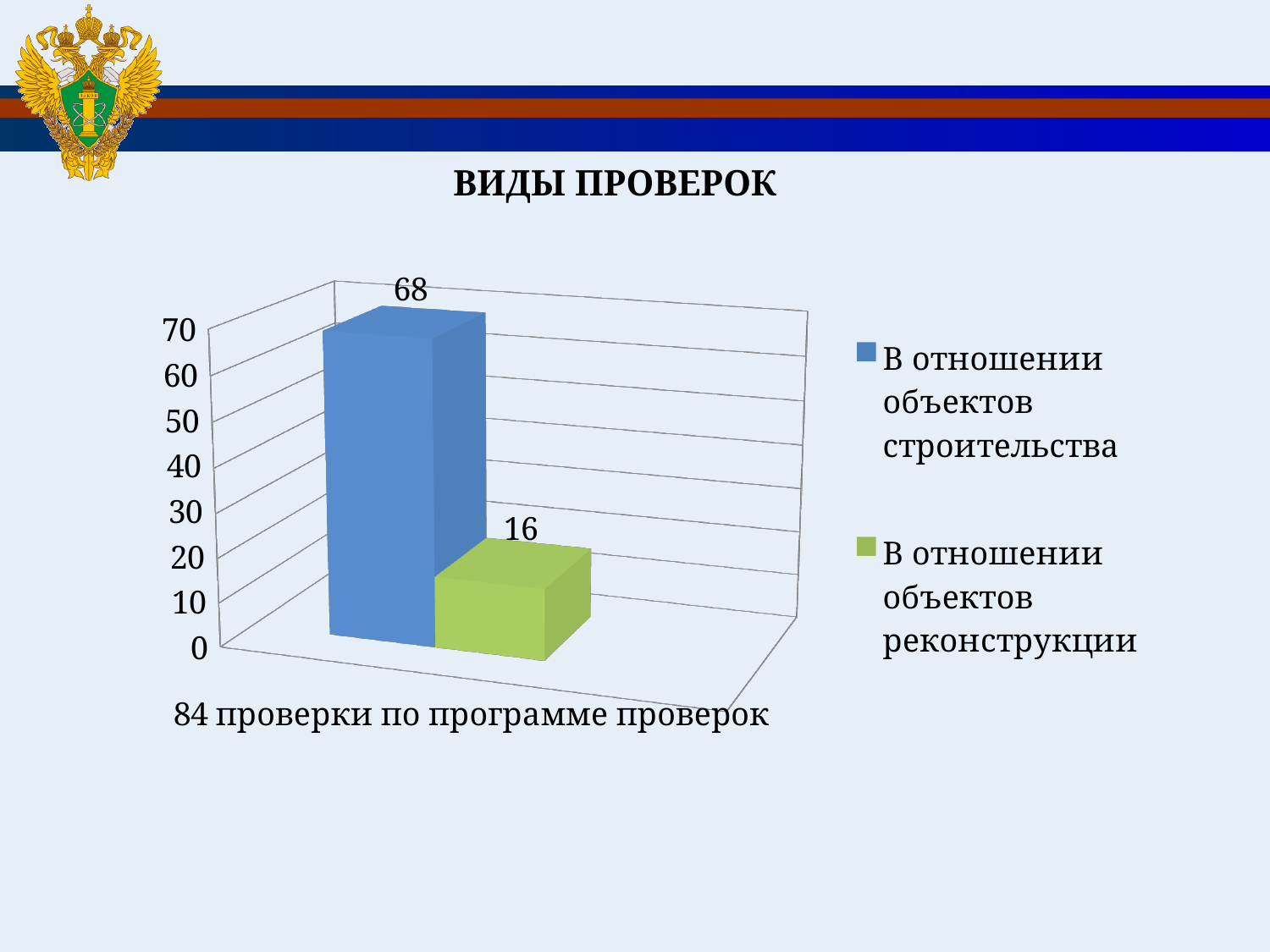
What is the title of the slide? ВИДЫ ПРОВЕРОК What is the total of the two values shown in the chart? 84 What is the value for 'В отношении объектов реконструкции'? 16 What kind of chart is shown on the slide? bar chart Is the value for 'В отношении объектов реконструкции' greater or less than 20? less Which series has the highest value? В отношении объектов строительства Is the value for 'В отношении объектов строительства' greater or less than 60? greater Which series has the lowest value? В отношении объектов реконструкции Which is larger: the value for 'В отношении объектов строительства' or for 'В отношении объектов реконструкции'? В отношении объектов строительства How many series does the legend list? 2 What is the value for 'В отношении объектов строительства'? 68 What is the difference between the values for 'В отношении объектов строительства' and 'В отношении объектов реконструкции'? 52